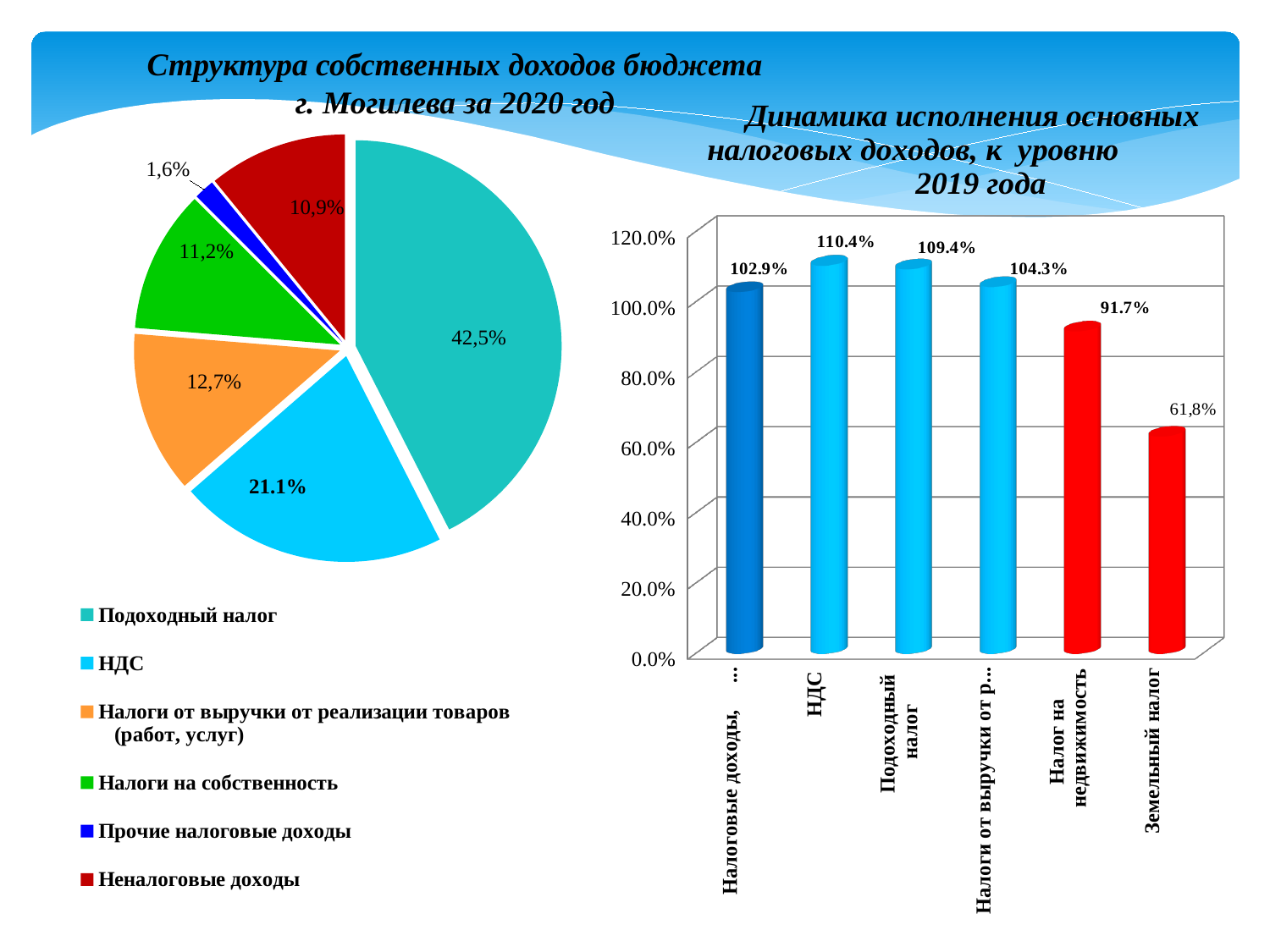
In the bar chart on the right, what is the value for Земельный налог? 61,8% In the pie chart 'Структура собственных доходов бюджета г. Могилева за 2020 год', what share does Подоходный налог have? 42,5% In the bar chart 'Динамика исполнения основных налоговых доходов, к уровню 2019 года', what is the value for НДС? 110.4% In the pie chart on the left, which category has the smallest slice? Прочие налоговые доходы In the bar chart on the right, is the value for Налог на недвижимость greater or less than 100.0%? less In the bar chart on the right, which category has the highest value? НДС In the pie chart on the left, which category has the largest slice? Подоходный налог In the pie chart on the left, how many categories does the legend list? 6 In the pie chart on the left, what is the difference between the shares of Налоги от выручки от реализации товаров (работ, услуг) and Налоги на собственность? 1,5% In the bar chart on the right, which category has the lowest value? Земельный налог What kind of chart is shown on the right side of the slide? bar chart In the pie chart on the left, what is the value for НДС? 21.1%